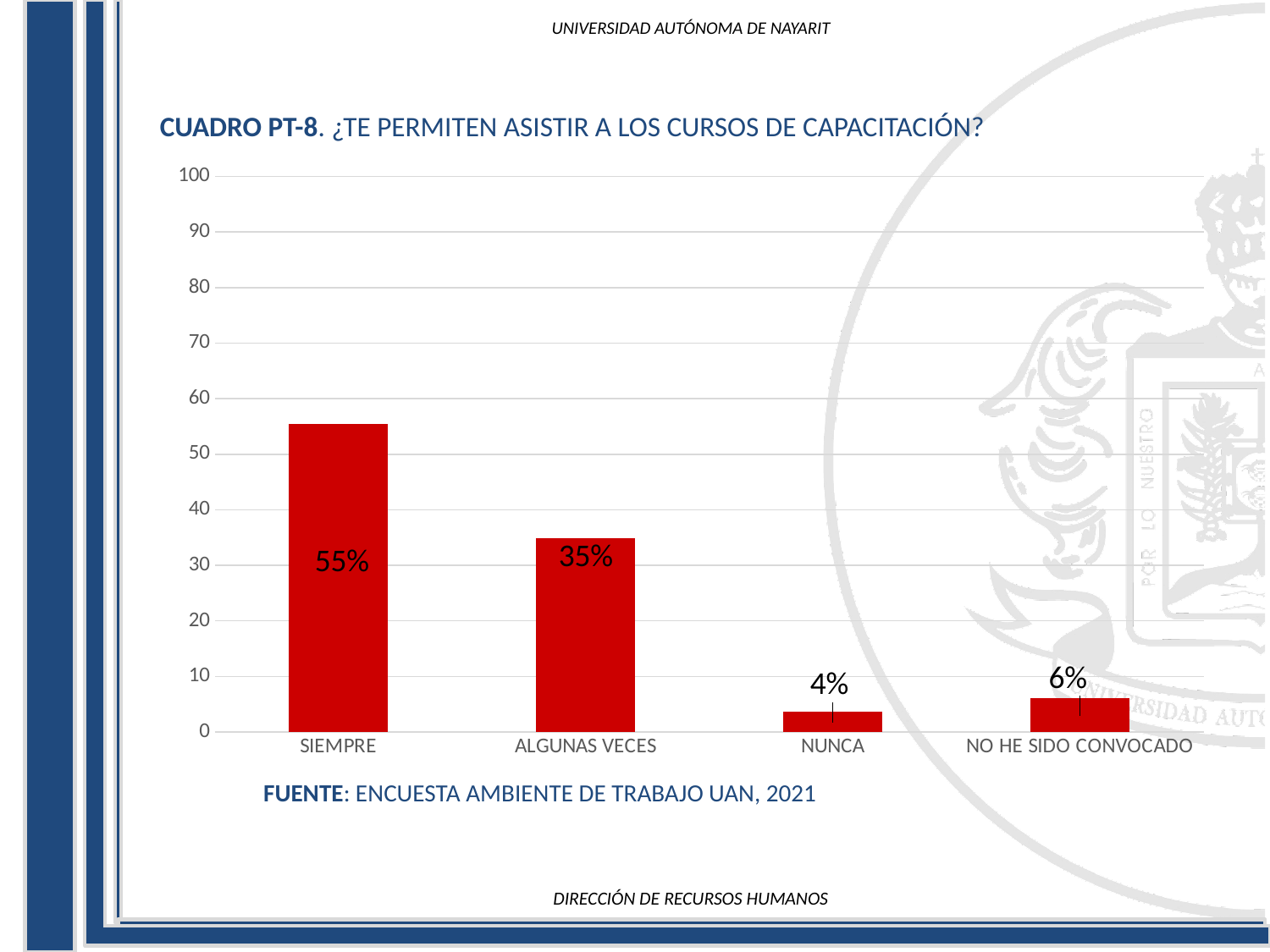
Which category has the lowest value? NUNCA Is the value for SIEMPRE greater or less than 50? greater What source is cited below the chart? ENCUESTA AMBIENTE DE TRABAJO UAN, 2021 What kind of chart is shown on the slide? bar chart How many categories are shown on the x axis? 4 Which is larger, the value for NUNCA or the value for NO HE SIDO CONVOCADO? NO HE SIDO CONVOCADO What is the value for SIEMPRE? 55% Which category has the highest value? SIEMPRE What is the value for NO HE SIDO CONVOCADO? 6% What is the difference between the values for SIEMPRE and ALGUNAS VECES? 20% What is the value for NUNCA? 4% What is the value for ALGUNAS VECES? 35%